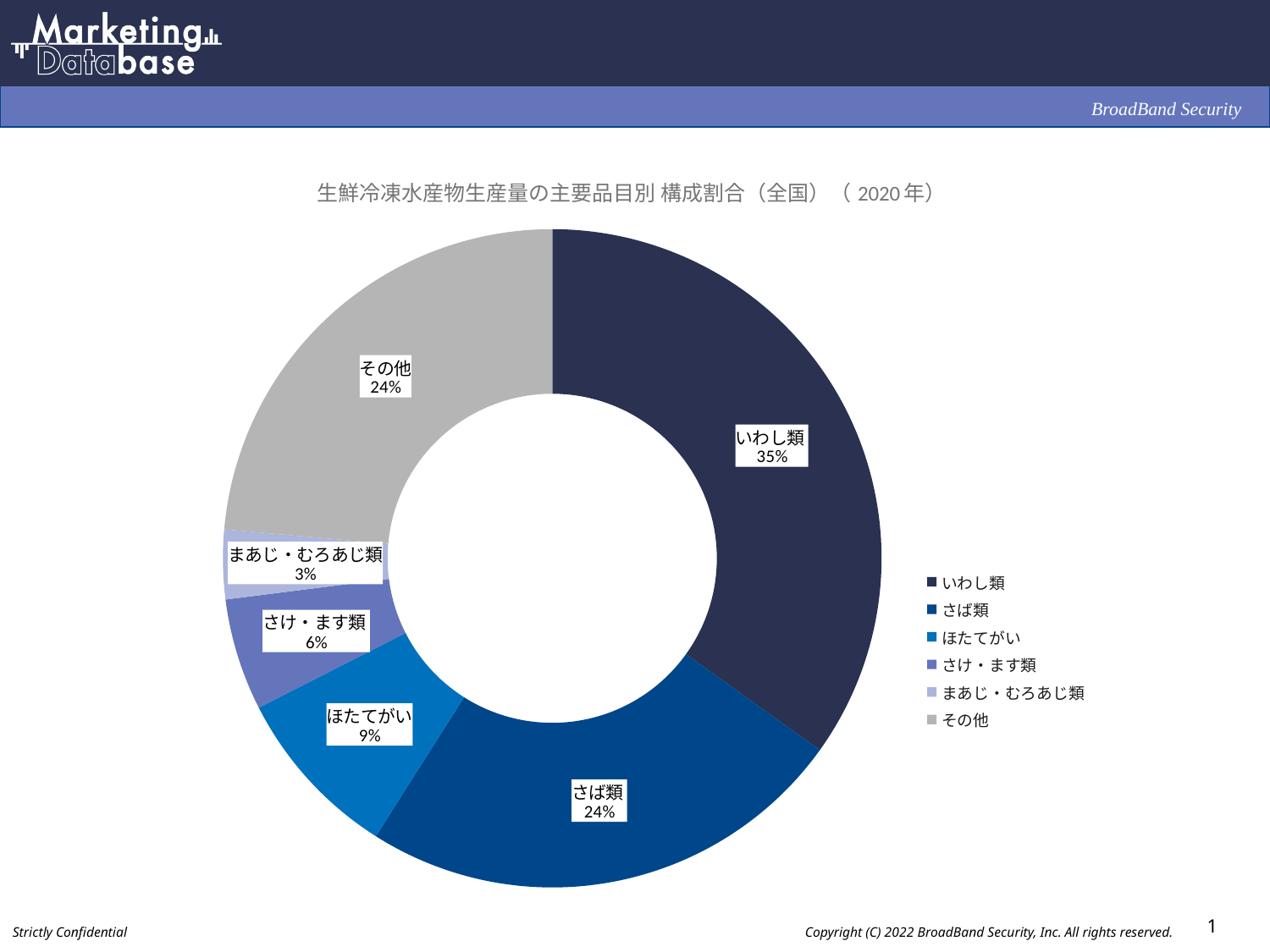
What is the difference in percentage points between いわし類 and さば類? 11 What share is shown for まあじ・むろあじ類? 3% Which category has the largest share of the pie? いわし類 Which category has the smallest share of the pie? まあじ・むろあじ類 How many entries does the legend list? 6 What is the title of the chart? 生鮮冷凍水産物生産量の主要品目別 構成割合（全国）（2020年） How many categories are shown in the chart? 6 Which is larger, the share for ほたてがい or the share for さけ・ます類? ほたてがい What share of the pie does いわし類 have? 35% What kind of chart is shown on the slide? Pie (doughnut) chart What is the value labelled for さけ・ます類? 6% What percentage is shown for ほたてがい? 9%